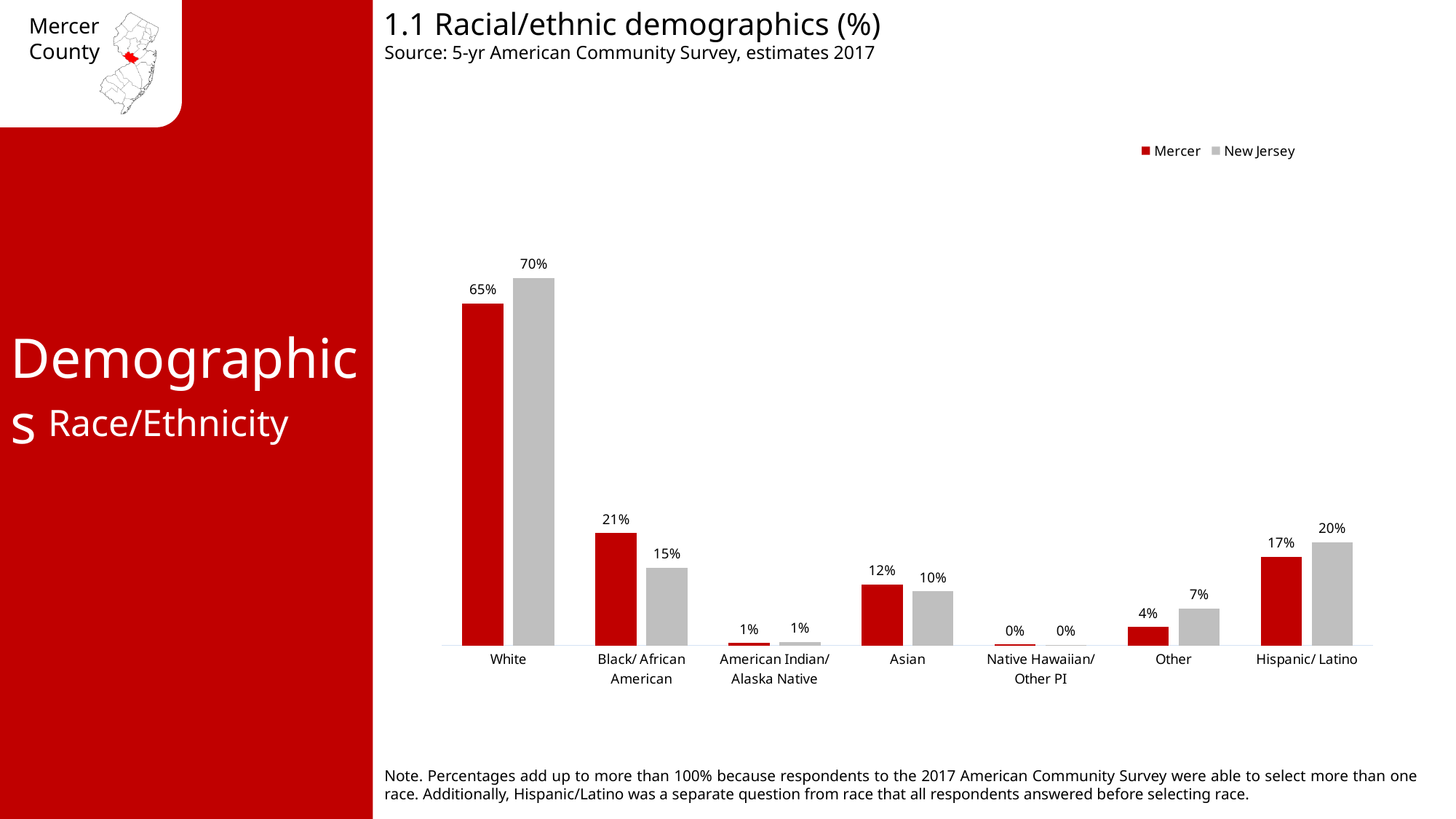
What is the New Jersey value for Other? 7% Which is larger for Black/ African American, the Mercer value or the New Jersey value? Mercer What is the Mercer value for White? 65% What kind of chart is shown? Bar chart How many categories are shown on the x axis? 7 What is the New Jersey value for Black/ African American? 15% What colour represents the Mercer series? Red How many series does the legend list? 2 Which category has the highest Mercer value? White What is the Mercer value for Asian? 12% What is the difference between the New Jersey and Mercer values for White? 5% Which category has the lowest New Jersey value? Native Hawaiian/ Other PI